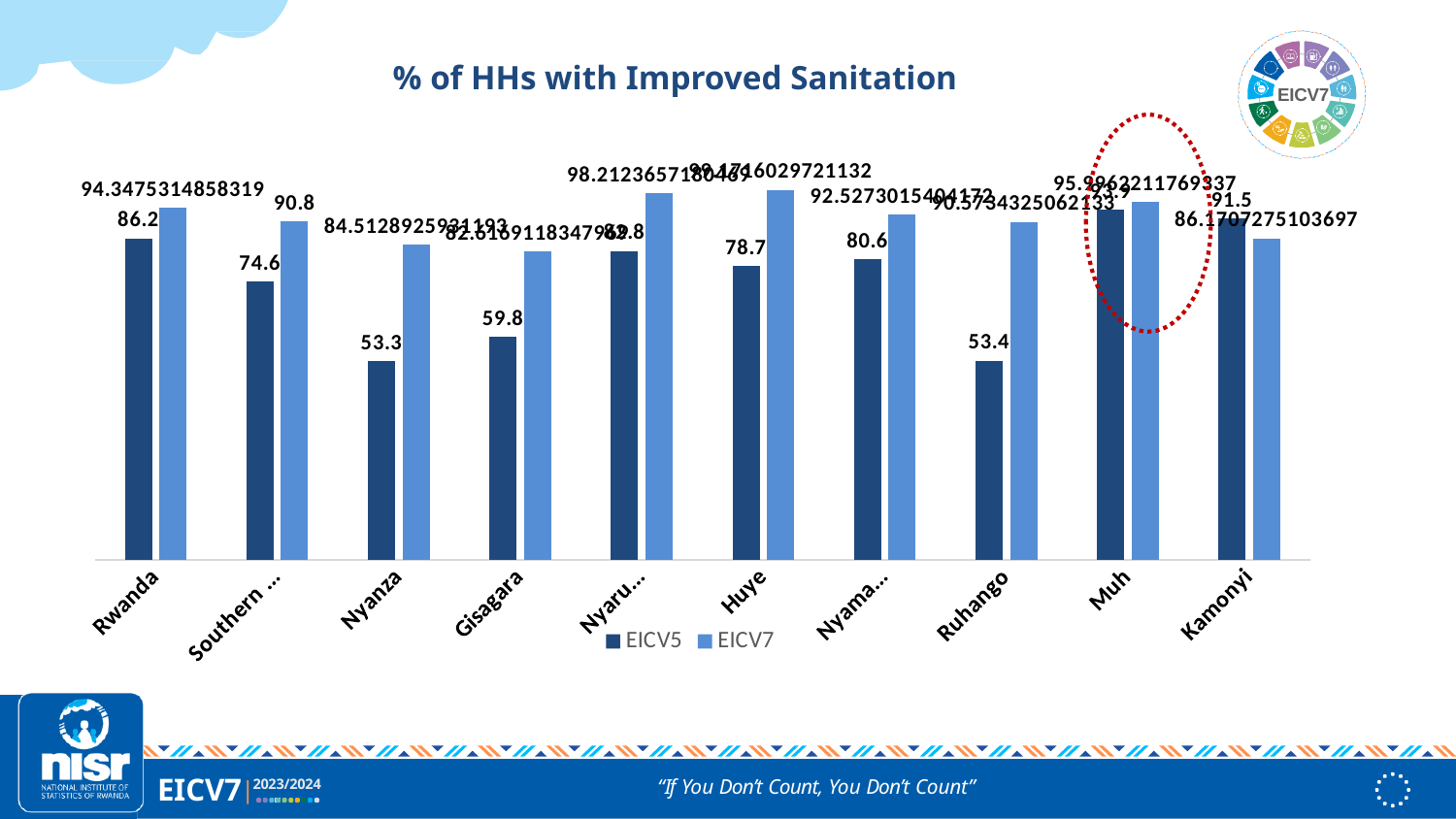
What is the EICV5 value for Rwanda? 86.2 What is the title of the chart? % of HHs with Improved Sanitation What kind of chart is shown on the slide? bar chart What is the difference between the EICV5 values for Gisagara and Nyanza? 6.5 What is the EICV5 value for Kamonyi? 91.5 How many categories are shown on the x axis? 10 How many series does the legend list? 2 What is the EICV5 value for Nyanza? 53.3 What is the difference between the EICV5 values for Rwanda and Southern? 11.6 For Kamonyi, which series has the larger value, EICV5 or EICV7? EICV5 What is the EICV5 value for Huye? 78.7 What is the EICV7 value for Southern? 90.8